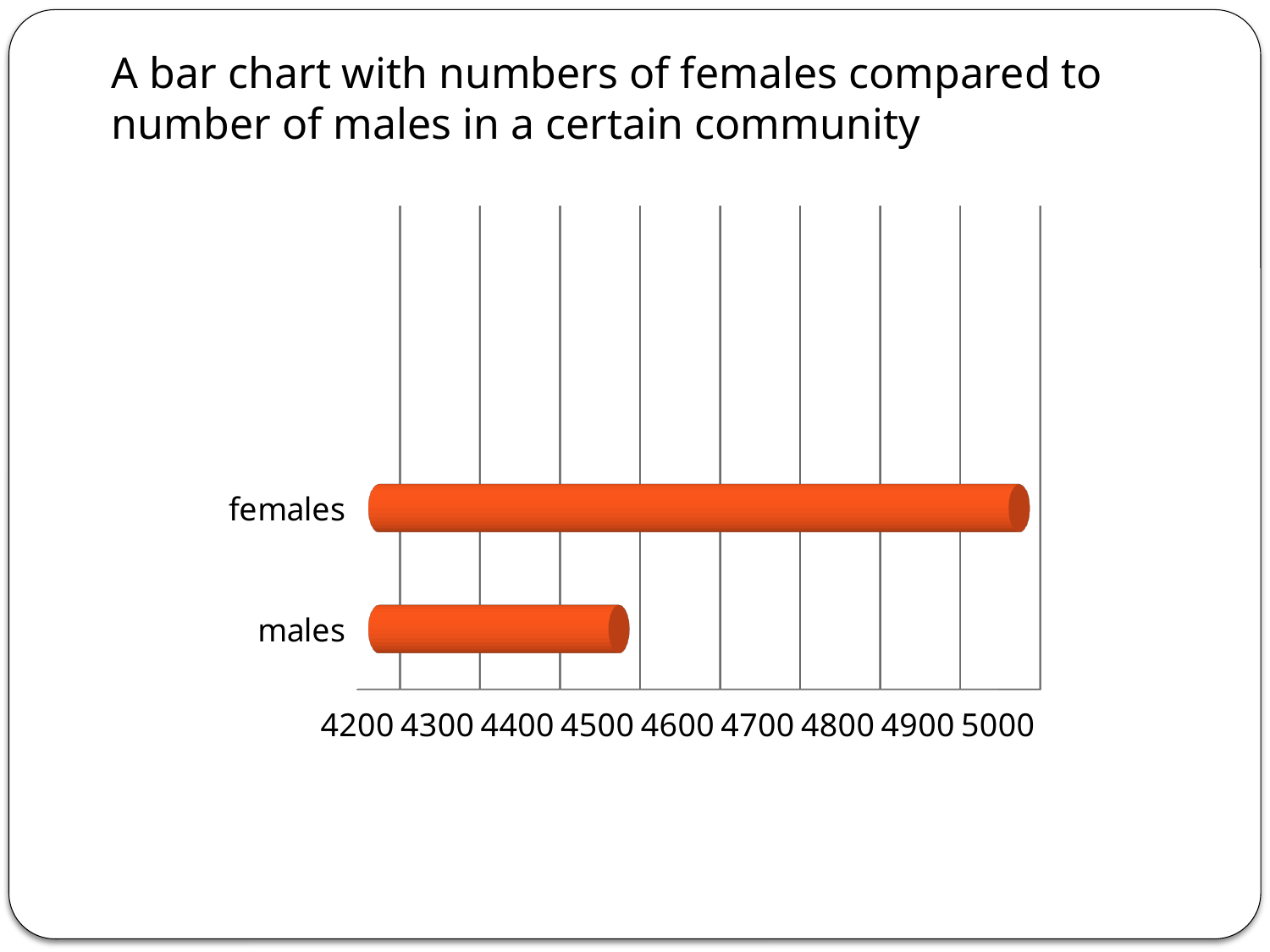
What is the lowest value shown on the horizontal axis of the chart? 4200 What kind of chart is shown on the slide? bar chart Is the value for females greater or less than 4700? greater Is the value for males greater or less than 4400? greater What is the highest value shown on the horizontal axis of the chart? 5000 Is the value for females greater or less than 4900? greater Which category has the highest value in the chart? females Which category has the lowest value in the chart? males Which is larger, the value for females or the value for males? females How many categories are plotted in the chart? 2